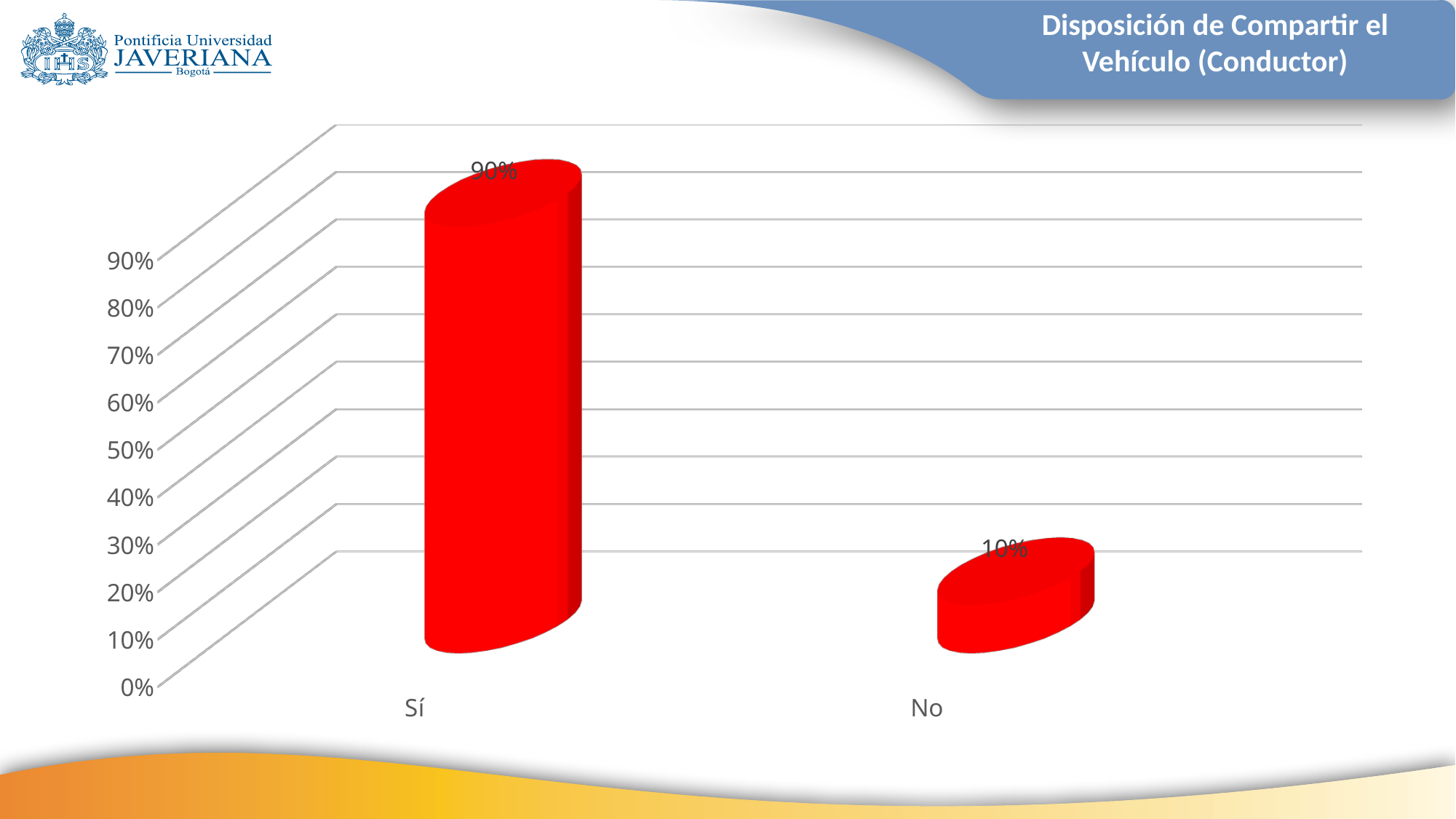
Which category has the lowest value? No Which category has the highest value? Sí What is the value for Sí? 90% How many categories are shown on the x axis? 2 Which is larger, the value for Sí or the value for No? Sí What colour are the bars in the chart? red What is the difference between the values for Sí and No? 80% What is the title shown on the slide? Disposición de Compartir el Vehículo (Conductor) Is the value for Sí greater or less than 50%? greater Is the value for No greater or less than 20%? less What is the value for No? 10% What kind of chart is shown on the slide? bar chart